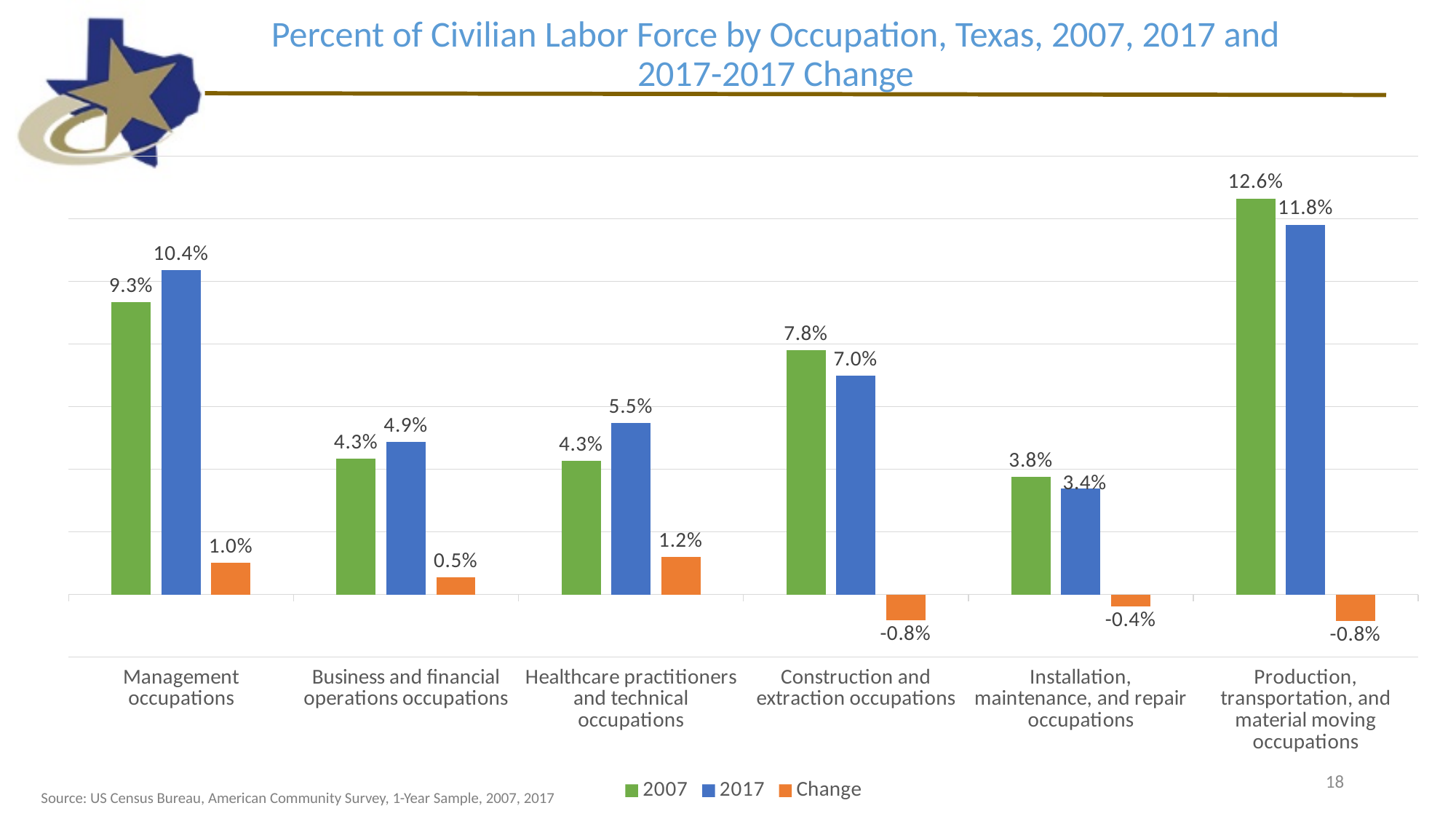
What is the Change value for Production, transportation, and material moving occupations? -0.8% What is the Change value for Healthcare practitioners and technical occupations? 1.2% What is the 2007 value for Construction and extraction occupations? 7.8% Which series is shown in orange in the legend? Change Which is larger for Installation, maintenance, and repair occupations: the 2007 value or the 2017 value? 2007 What is the 2017 value for Management occupations? 10.4% What kind of chart is shown on the slide? Bar chart How many occupation categories are shown on the x axis? 6 Which occupation category has the highest 2017 value? Production, transportation, and material moving occupations How many series does the legend list? 3 What is the difference between the 2017 and 2007 values for Business and financial operations occupations? 0.6% Which occupation category has the lowest 2007 value? Installation, maintenance, and repair occupations